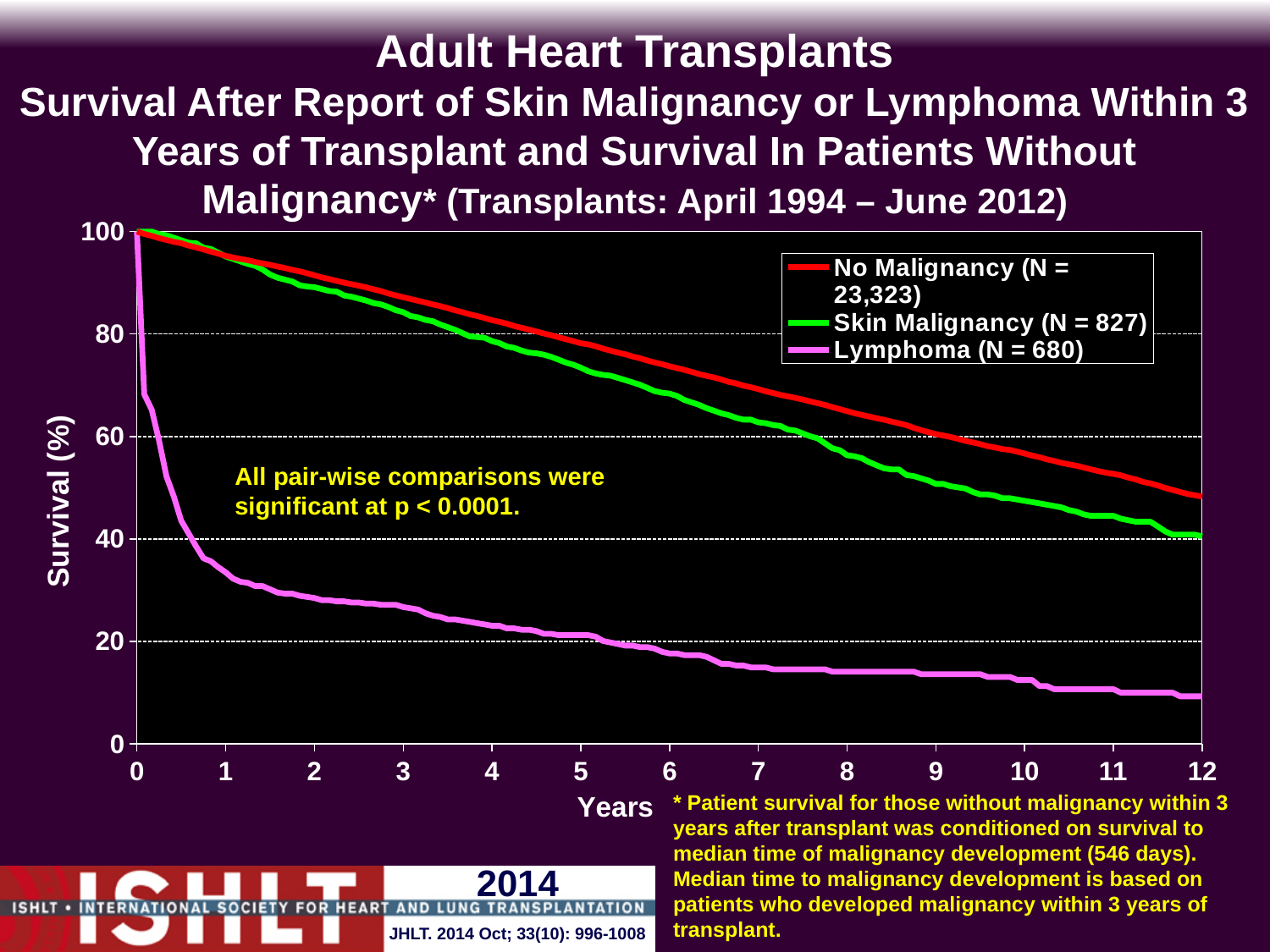
At 12 years, which series has higher survival: No Malignancy or Skin Malignancy? No Malignancy Which series has the lowest survival at 12 years? Lymphoma According to the legend, what is the N for the No Malignancy group? 23,323 Is the survival value for Lymphoma at 12 years greater or less than 20? less How many series does the legend list? 3 Is the survival value for Lymphoma at 1 year greater or less than 40? less According to the legend, what is the N for the Lymphoma group? 680 What kind of chart is shown on the slide? Line chart Is the survival value for No Malignancy at 12 years greater or less than 40? greater At 6 years, which series has higher survival: Skin Malignancy or Lymphoma? Skin Malignancy Does the Lymphoma survival curve rise or fall as years increase? Falls